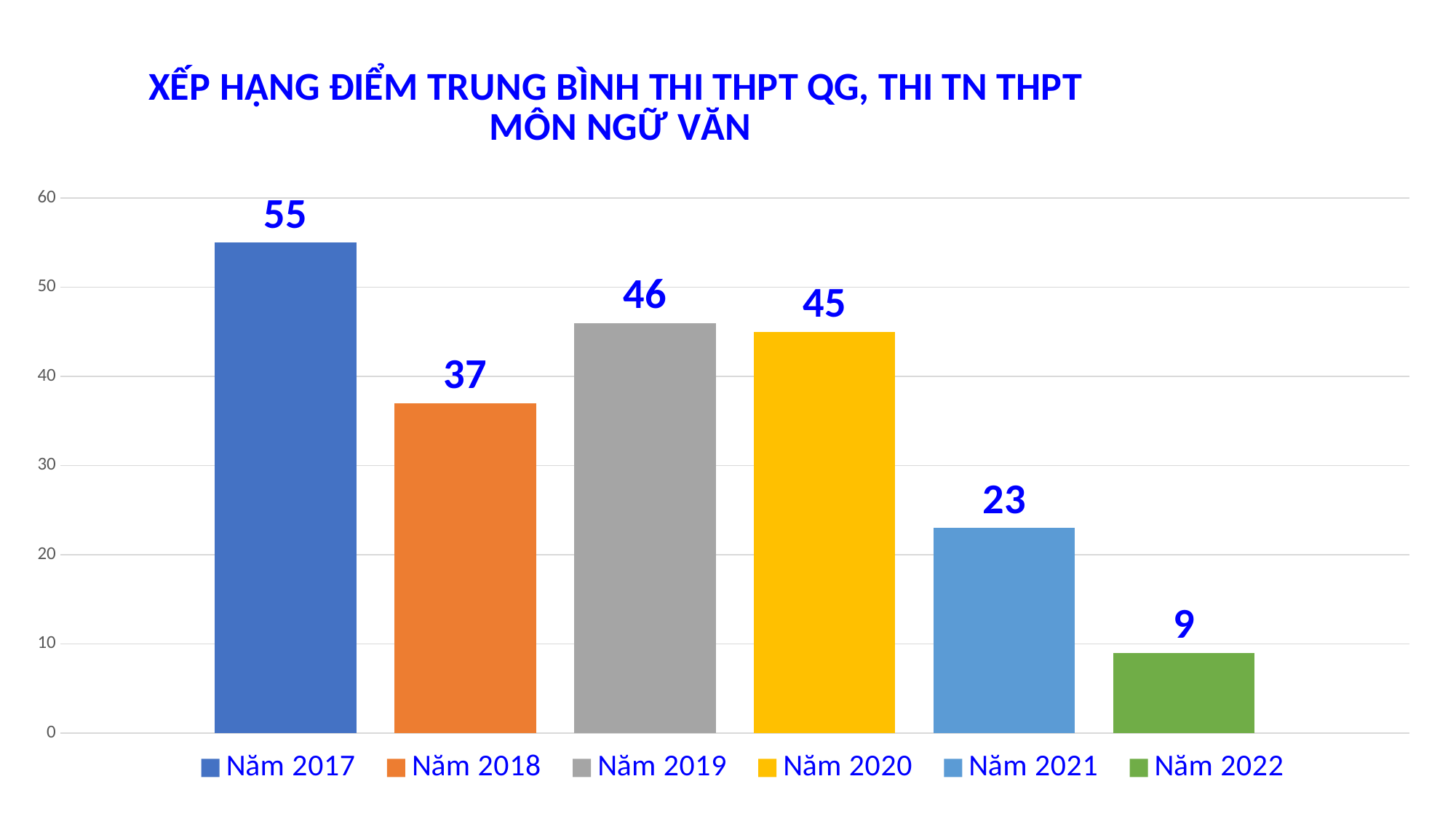
What is the value for Năm 2020? 45 Which year has the lowest value? Năm 2022 Which year has the highest value? Năm 2017 What is the difference between the values for Năm 2021 and Năm 2022? 14 Is the value for Năm 2021 greater or less than 30? less What is the value for Năm 2017? 55 What is the value for Năm 2022? 9 Which is larger, the value for Năm 2019 or the value for Năm 2018? Năm 2019 How many years are shown in the chart? 6 What is the difference between the values for Năm 2017 and Năm 2018? 18 What kind of chart is shown on the slide? bar chart What colour is the bar for Năm 2020? yellow